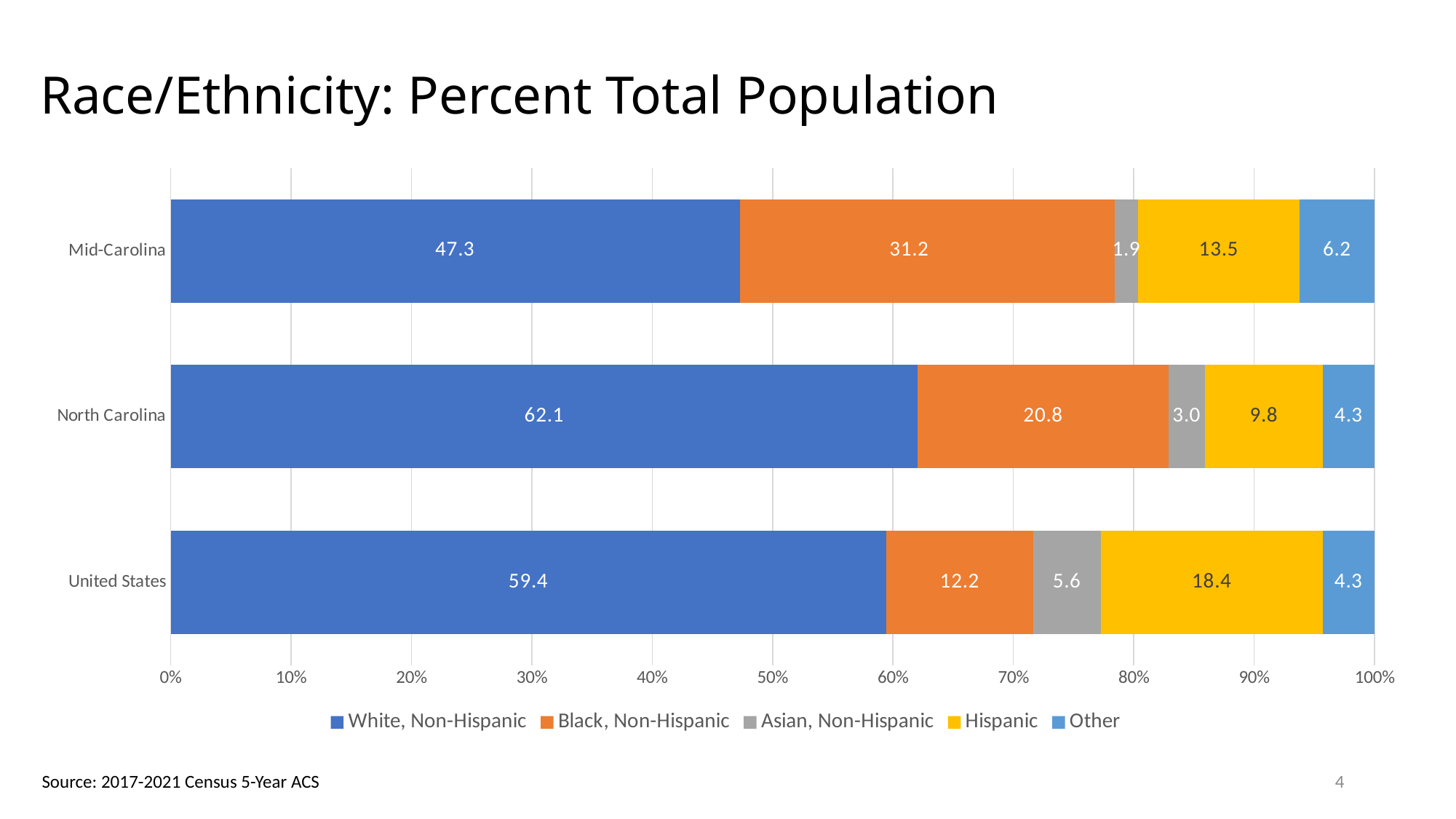
What is the title of the chart? Race/Ethnicity: Percent Total Population What kind of chart is shown on the slide? Stacked bar chart How many regions are shown on the chart? 3 How many series does the legend list? 5 Which region has the highest White, Non-Hispanic value? North Carolina What is the Black, Non-Hispanic value for North Carolina? 20.8 Which region has the lowest Hispanic value? North Carolina What is the White, Non-Hispanic value for Mid-Carolina? 47.3 Which is larger, the Other value for Mid-Carolina or for North Carolina? Mid-Carolina What is the Asian, Non-Hispanic value for Mid-Carolina? 1.9 What is the Hispanic value for the United States? 18.4 What is the difference between the Black, Non-Hispanic values for Mid-Carolina and the United States? 19.0